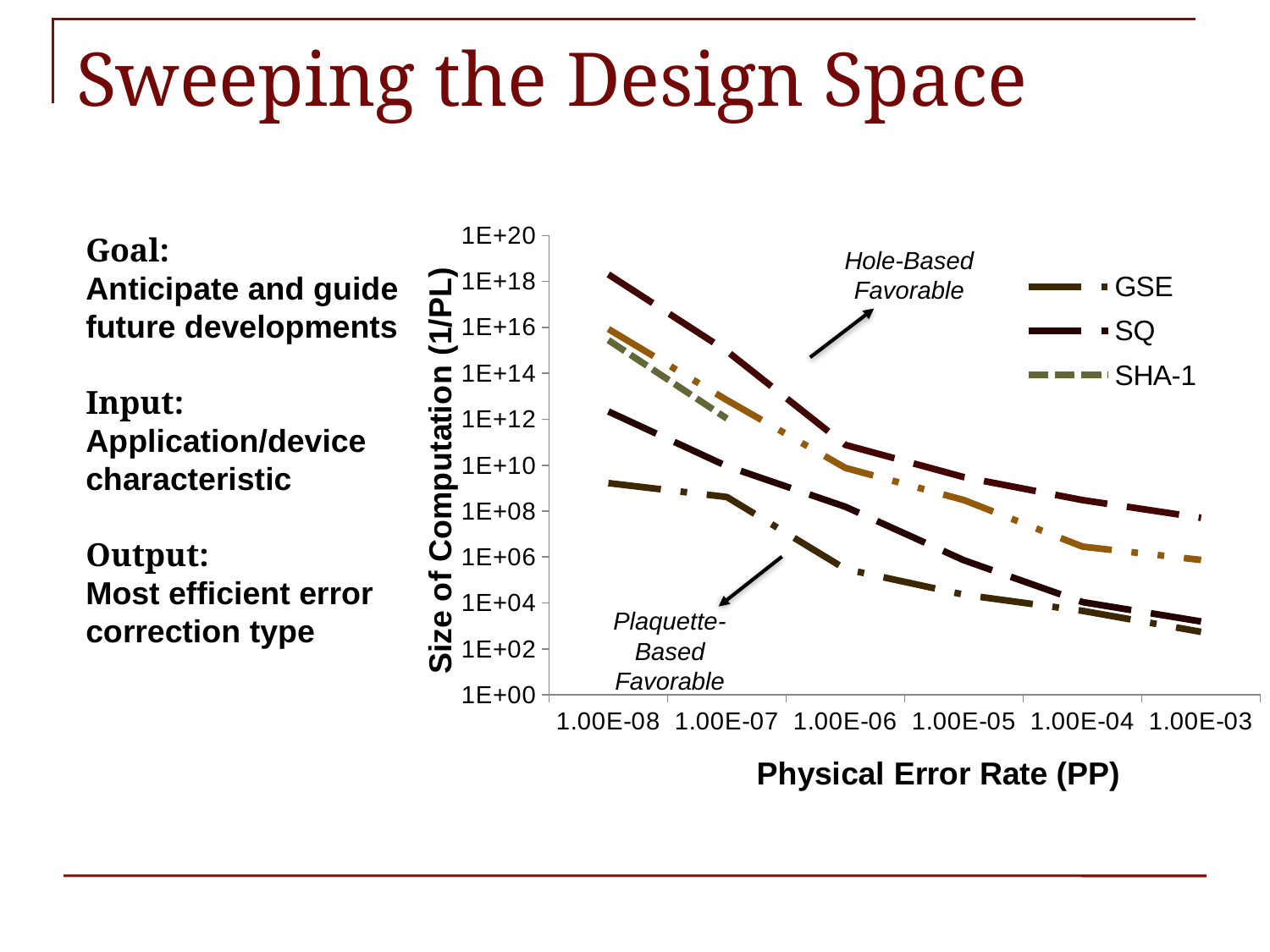
Do the plotted lines rise or fall as the physical error rate increases along the x axis? fall Is the value of the lowest plotted line at 1.00E-07 greater or less than 1E+10? less Is the value of the highest plotted line at 1.00E-06 greater or less than 1E+10? greater How many series does the chart legend list? 3 Which series are listed in the chart legend? GSE, SQ, SHA-1 What is the label of the x axis of the chart? Physical Error Rate (PP) How many tick labels are shown on the x axis of the chart? 6 Is the value of the lowest plotted line at 1.00E-03 greater or less than 1E+04? less What kind of chart is shown on the slide? line chart